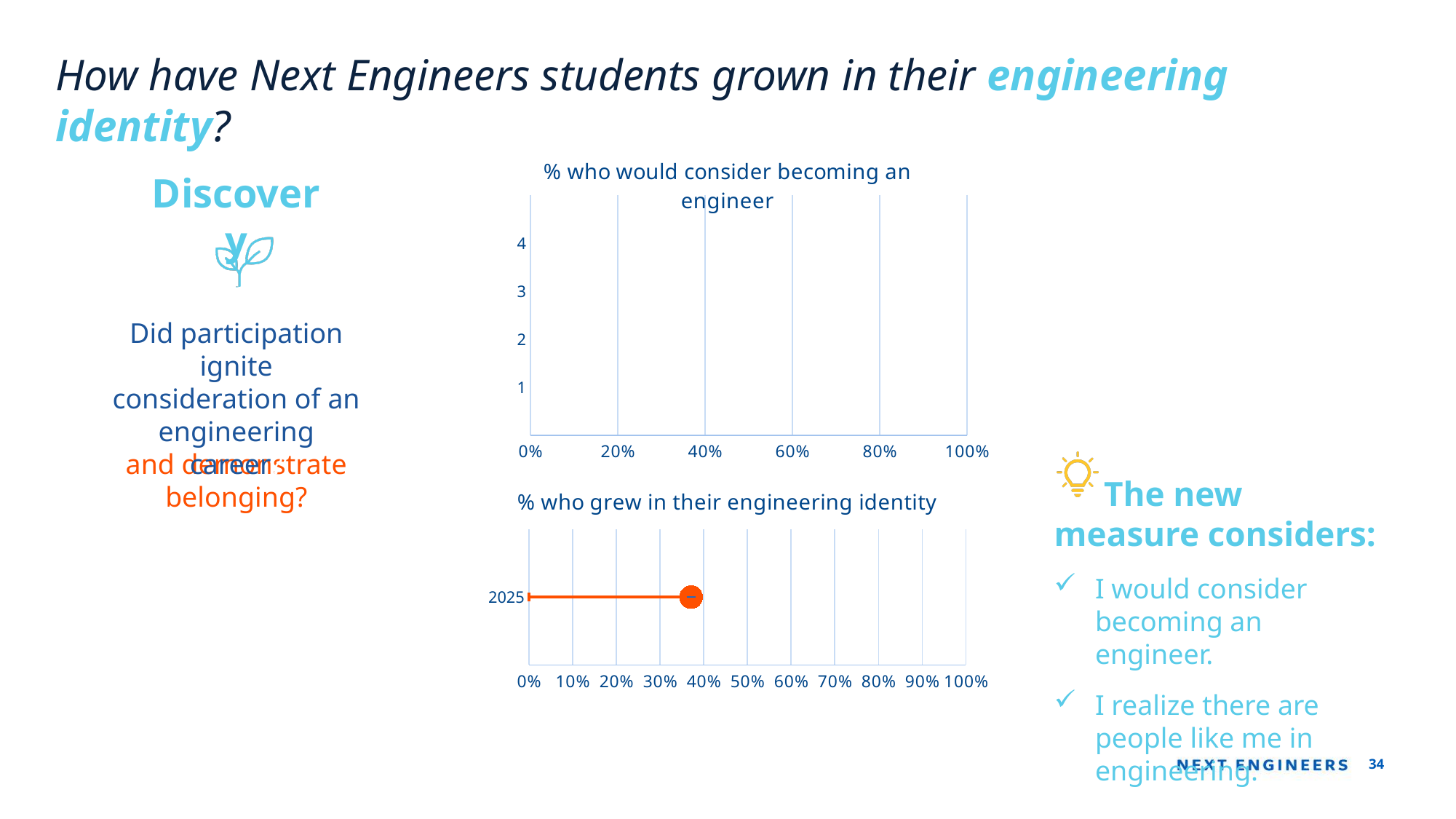
In the bottom chart, '% who grew in their engineering identity', is the value for 2025 greater or less than 20%? greater What is the title of the bottom chart on the slide? % who grew in their engineering identity In the bottom chart, '% who grew in their engineering identity', is the value for 2025 greater or less than 60%? less What is the title of the top chart on the slide? % who would consider becoming an engineer In the bottom chart, '% who grew in their engineering identity', what is the label of the single category shown? 2025 What kind of chart is the bottom chart, '% who grew in their engineering identity'? lollipop chart In the bottom chart, '% who grew in their engineering identity', how many categories are plotted? 1 In the bottom chart, '% who grew in their engineering identity', is the value for 2025 greater or less than 30%? greater In the bottom chart, '% who grew in their engineering identity', what is the highest value shown on the x axis? 100%